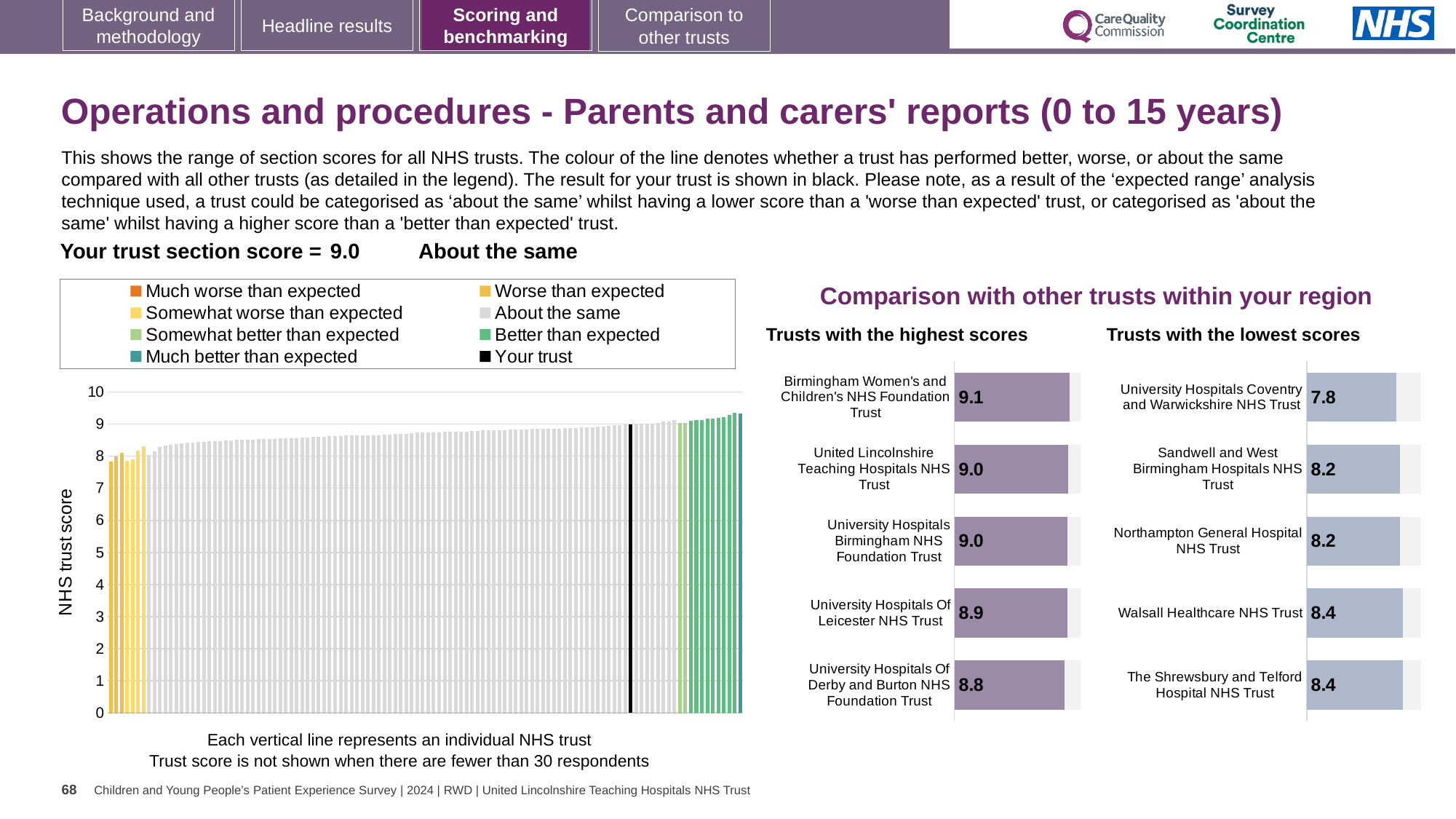
In the 'Trusts with the lowest scores' chart, which has the larger score: Northampton General Hospital NHS Trust or University Hospitals Coventry and Warwickshire NHS Trust? Northampton General Hospital NHS Trust In the 'Trusts with the highest scores' chart, what is the difference between the scores of Birmingham Women's and Children's NHS Foundation Trust and University Hospitals Of Derby and Burton NHS Foundation Trust? 0.3 In the 'Trusts with the lowest scores' chart, what is the difference between the scores of Walsall Healthcare NHS Trust and University Hospitals Coventry and Warwickshire NHS Trust? 0.6 What kind of chart is the large chart on the left showing NHS trust scores? Bar chart How many entries does the legend of the left-hand NHS trust score chart list? 8 In the 'Trusts with the highest scores' chart, which trust has the lowest score? University Hospitals Of Derby and Burton NHS Foundation Trust In the 'Trusts with the highest scores' chart, what is the score for Birmingham Women's and Children's NHS Foundation Trust? 9.1 In the 'Trusts with the lowest scores' chart, what is the score for The Shrewsbury and Telford Hospital NHS Trust? 8.4 In the 'Trusts with the lowest scores' chart, which trust has the lowest score? University Hospitals Coventry and Warwickshire NHS Trust In the 'Trusts with the highest scores' chart, how many trusts are shown? 5 In the 'Trusts with the lowest scores' chart, what is the score for University Hospitals Coventry and Warwickshire NHS Trust? 7.8 In the 'Trusts with the highest scores' chart, what is the score for University Hospitals Of Leicester NHS Trust? 8.9